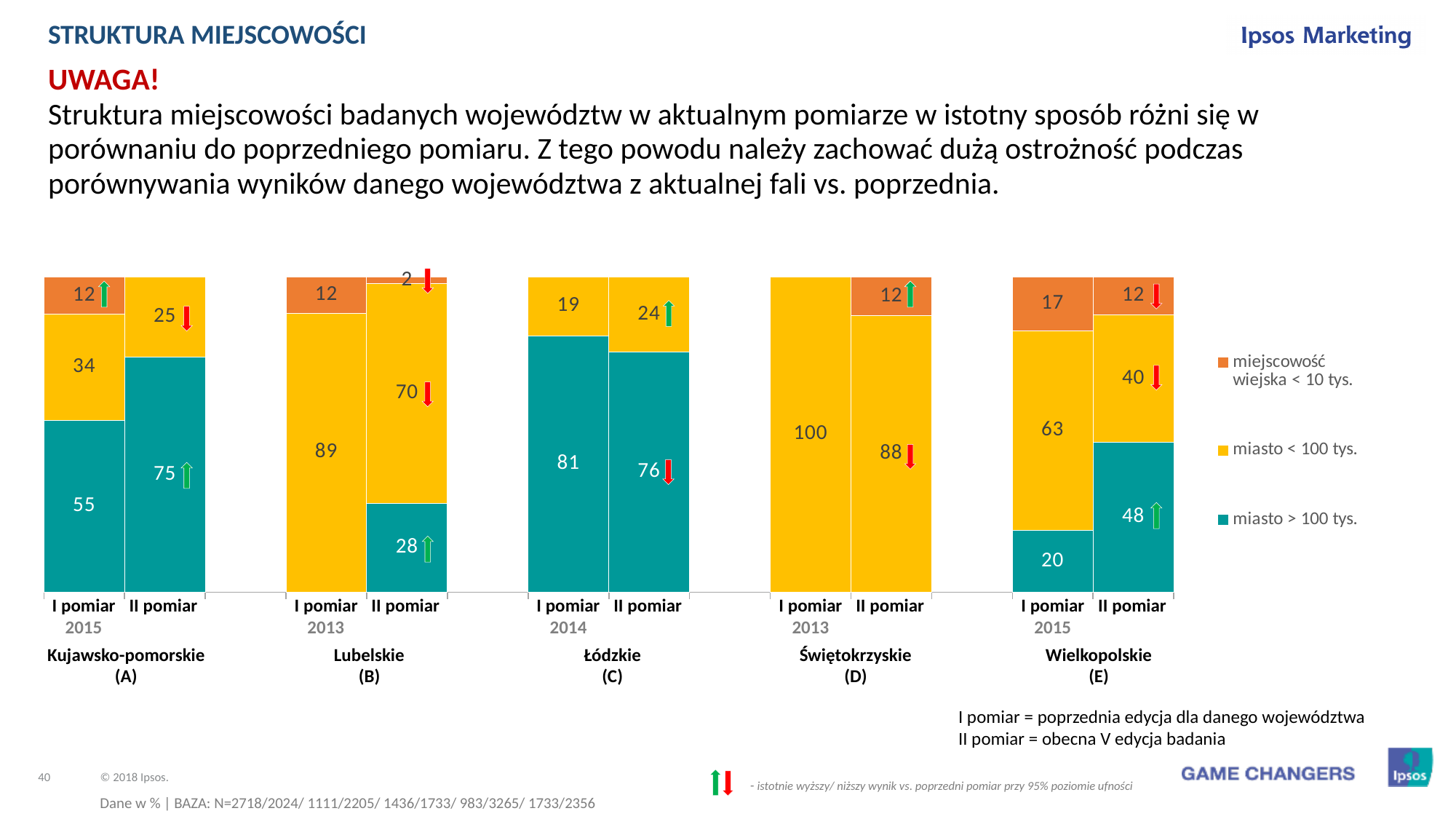
In the I pomiar bar for Wielkopolskie (E), which is larger: miasto < 100 tys. or miasto > 100 tys.? miasto < 100 tys. For Łódzkie (C), what is the difference between the miasto > 100 tys. values in I pomiar and II pomiar? 5 What is the value for miasto < 100 tys. in the I pomiar bar for Świętokrzyskie (D)? 100 Which year is shown under the I pomiar bar for Łódzkie (C)? 2014 What is the value for miasto > 100 tys. in the II pomiar bar for Kujawsko-pomorskie (A)? 75 How many series does the legend list? 3 Among the I pomiar bars, which region has the highest value for miasto > 100 tys.? Łódzkie (C) What is the total of the II pomiar stacked bar for Lubelskie (B)? 100 What is the value for miejscowość wiejska < 10 tys. in the II pomiar bar for Lubelskie (B)? 2 How many regions (województwa) are shown in the chart? 5 What is the value for miasto < 100 tys. in the I pomiar bar for Lubelskie (B)? 89 What kind of chart is shown on the slide? Stacked bar chart